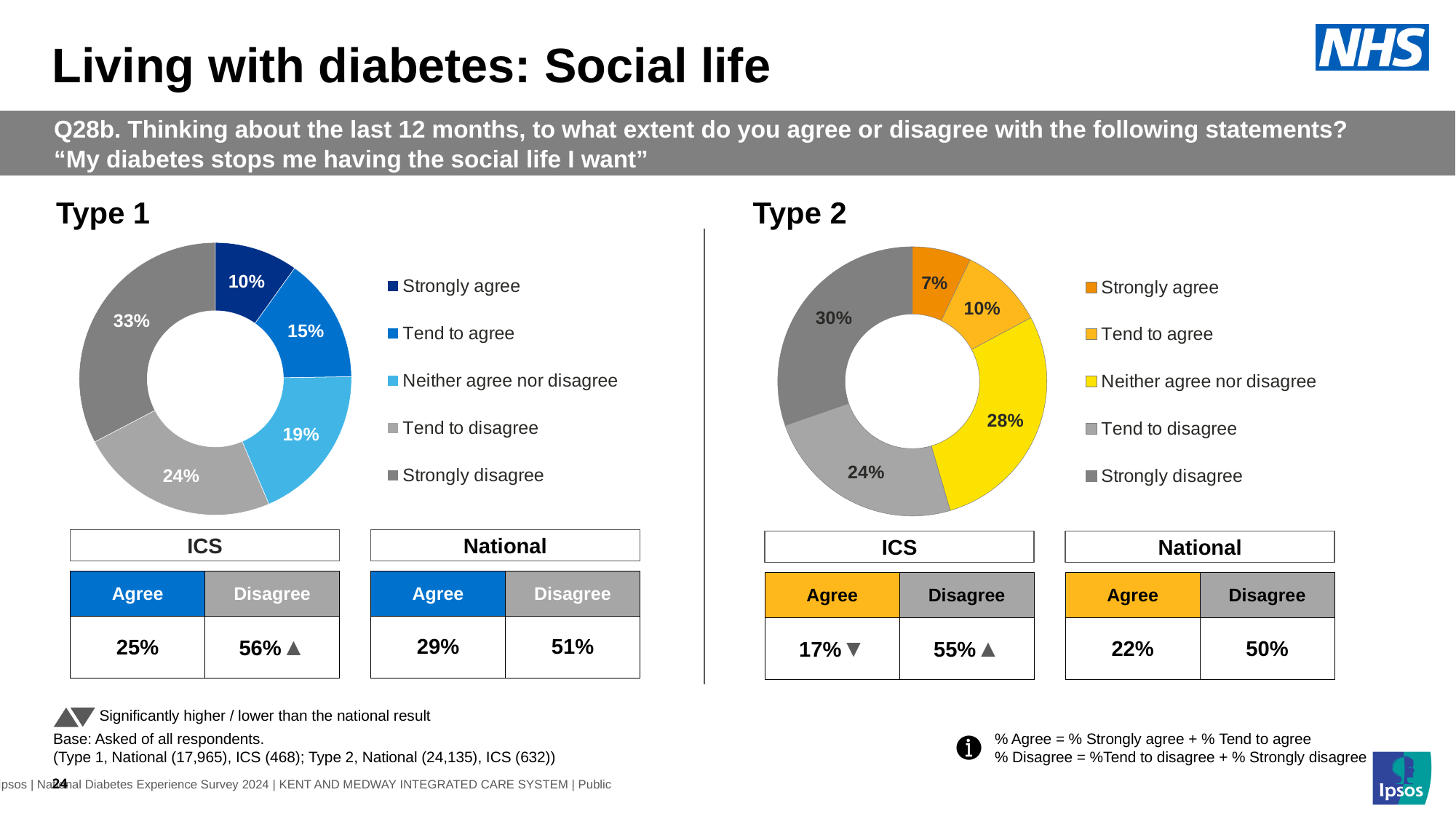
In the Type 2 chart, which response category has the smallest share? Strongly agree In the Type 2 chart, which is larger: the 'Tend to agree' share or the 'Tend to disagree' share? Tend to disagree In the Type 2 chart, what percentage of respondents said 'Strongly disagree'? 30% In the Type 2 chart, what is the combined share of 'Tend to disagree' and 'Strongly disagree'? 54% In the Type 1 chart, what is the combined share of 'Strongly agree' and 'Tend to agree'? 25% In the Type 1 chart, which response category has the largest share? Strongly disagree In the Type 1 chart, what colour is the 'Neither agree nor disagree' segment? Light blue How many response categories does the Type 1 chart show? 5 In the Type 1 chart, what is the difference between the 'Strongly disagree' share and the 'Tend to disagree' share? 9 percentage points In the Type 1 chart, what percentage of respondents said 'Strongly agree'? 10% What kind of chart is used for the Type 2 results? Doughnut chart In the Type 2 chart, what percentage of respondents said 'Neither agree nor disagree'? 28%